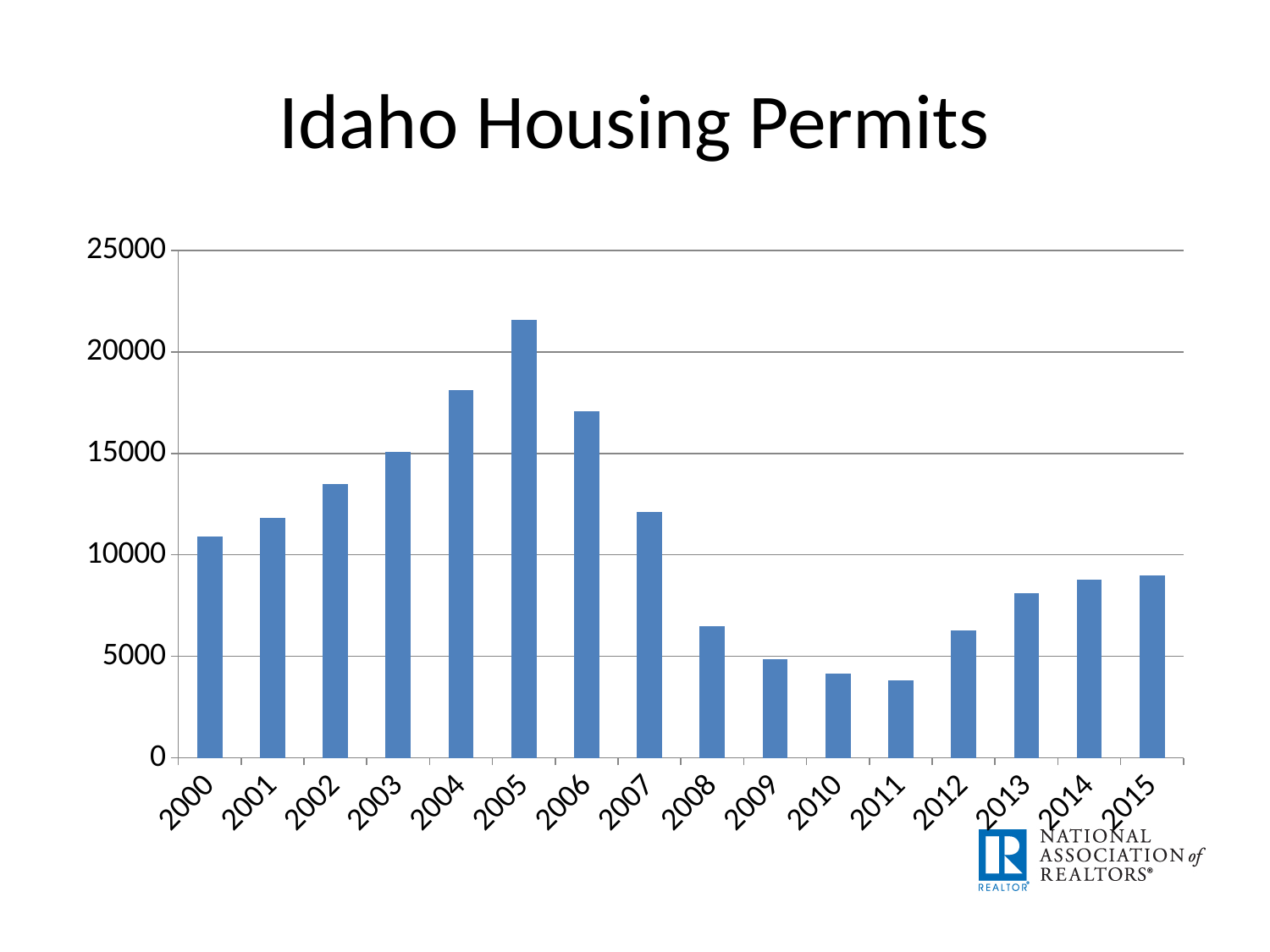
Which year has the larger value, 2004 or 2006? 2004 Is the value for 2015 greater or less than 10000? less Is the value for 2004 greater or less than 20000? less What is the title of the chart? Idaho Housing Permits Is the value for 2011 greater or less than 5000? less Which year has the highest number of housing permits? 2005 Do the values rise or fall from 2005 to 2011? fall How many years are plotted on the x axis? 16 Which year has the larger value, 2013 or 2015? 2015 What kind of chart is shown on the slide? bar chart